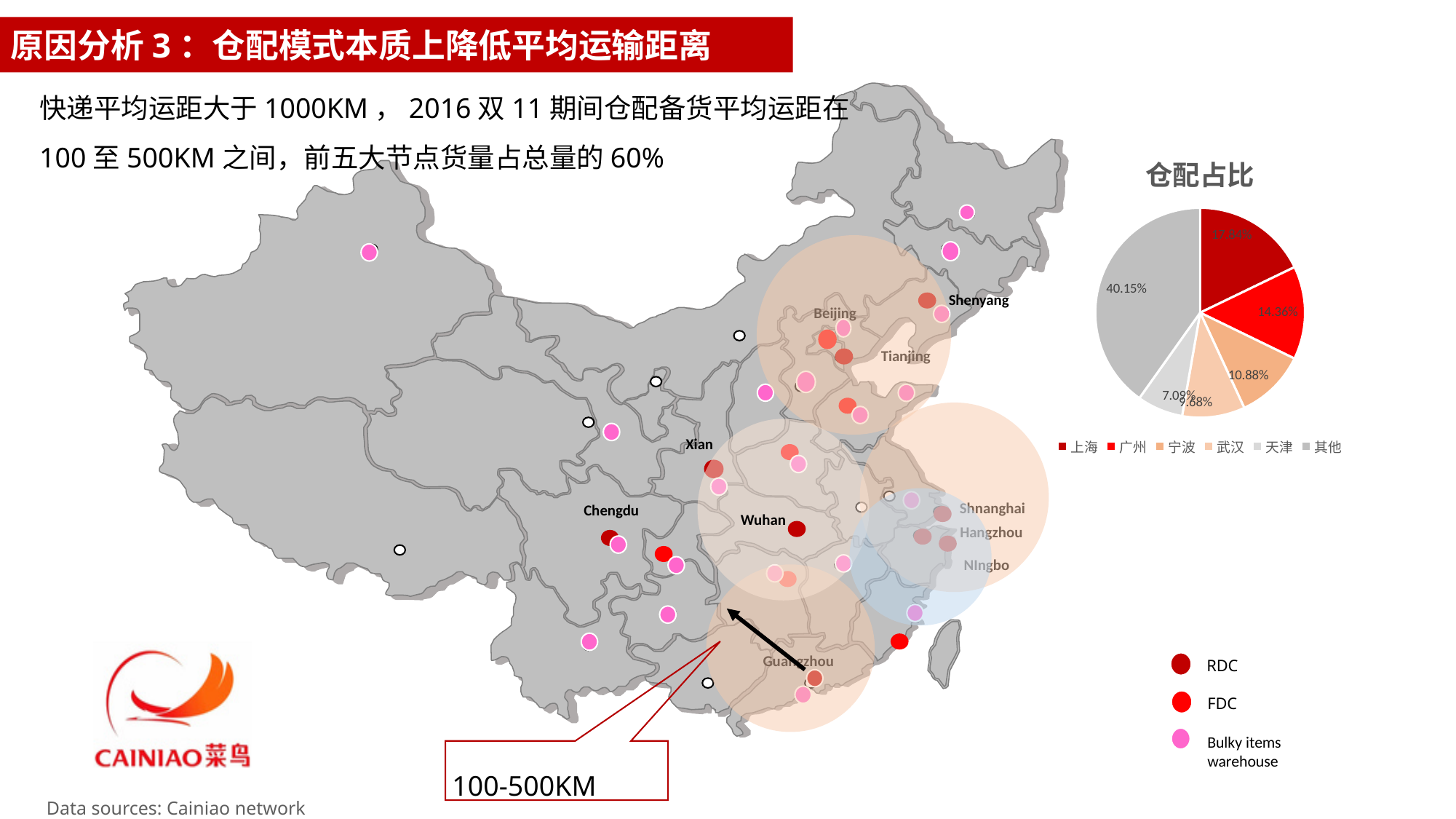
In the 仓配占比 pie chart, which category has the largest slice? 其他 In the 仓配占比 pie chart, what share does 天津 have? 7.09% In the 仓配占比 pie chart, what share does 宁波 have? 10.88% What type of chart is the 仓配占比 chart? pie chart In the 仓配占比 pie chart, what share does 广州 have? 14.36% In the 仓配占比 pie chart, what is the difference between the shares of 广州 and 武汉? 4.68% How many categories does the legend of the 仓配占比 pie chart list? 6 In the 仓配占比 pie chart, what share does 其他 have? 40.15% In the 仓配占比 pie chart, which is larger, 广州 or 宁波? 广州 In the 仓配占比 pie chart, which category has the smallest slice? 天津 What is the title of the pie chart on the slide? 仓配占比 In the 仓配占比 pie chart, what share does 武汉 have? 9.68%